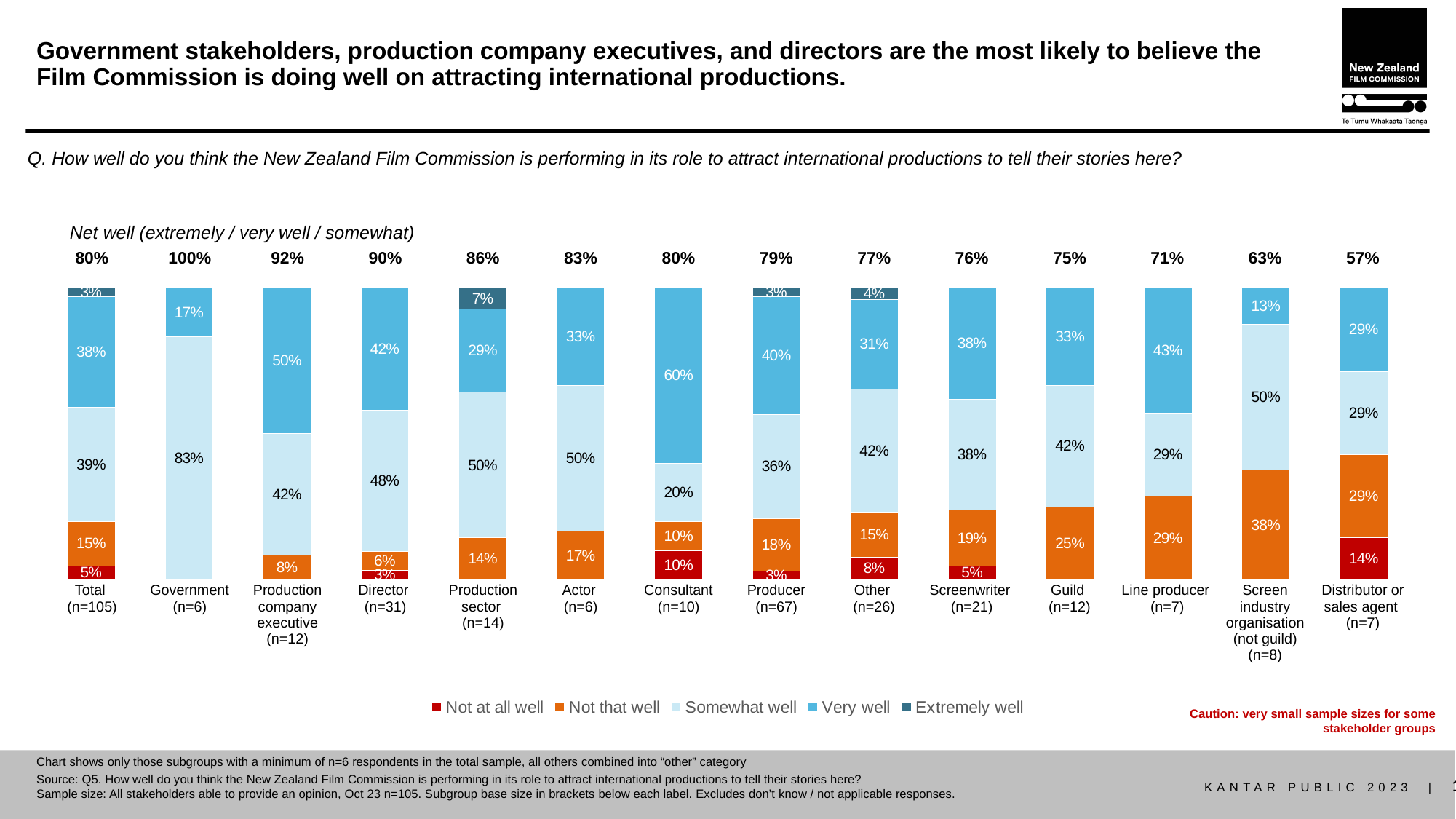
What is the 'Not that well' value for Screen industry organisation (not guild) (n=8)? 38% How many series does the legend list? 5 Which is larger: the 'Very well' value for Production company executive (n=12) or for Actor (n=6)? Production company executive (n=12) What type of chart is shown on the slide? Stacked bar chart How many stakeholder groups are shown along the x axis? 14 Which stakeholder group has the highest Net well percentage? Government (n=6) Which stakeholder group has the lowest Net well percentage? Distributor or sales agent (n=7) What is the 'Somewhat well' value for Government (n=6)? 83% What is the difference between the Net well percentage for Director (n=31) and for Line producer (n=7)? 19 percentage points What is the Net well percentage for Total (n=105)? 80% What is the 'Not at all well' value for Distributor or sales agent (n=7)? 14% What is the 'Very well' value for Consultant (n=10)? 60%